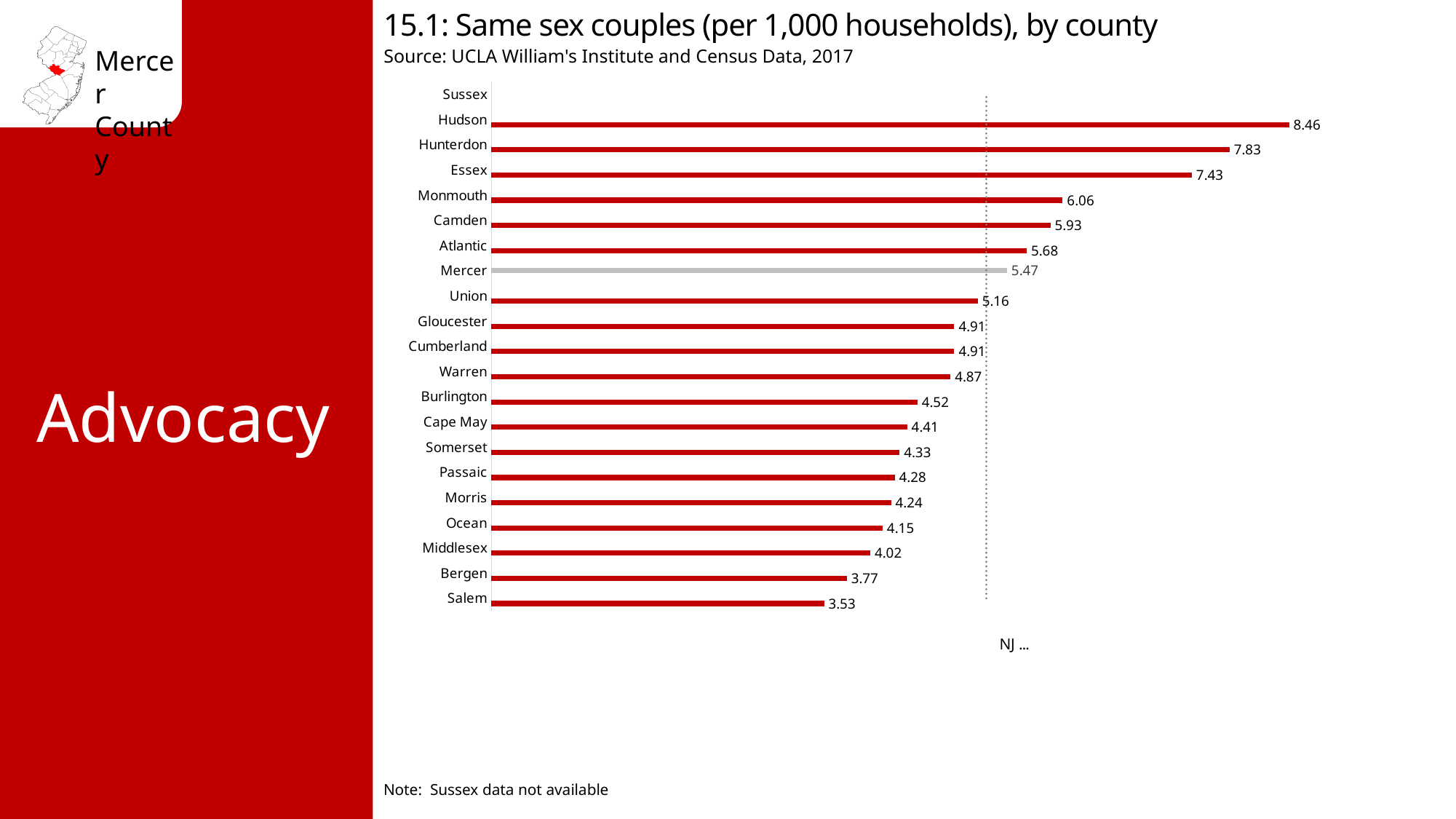
Which has a larger value, Essex or Monmouth? Essex Which county has the lowest value shown? Salem Which has a larger value, Bergen or Middlesex? Middlesex What is the value for Mercer County? 5.47 What is the title of the chart? 15.1: Same sex couples (per 1,000 households), by county What is the difference between the values for Hudson and Mercer? 2.99 What is the value for Salem County? 3.53 How many counties have a data label printed on the chart? 20 What kind of chart is shown? Bar chart What is the value for Hudson County? 8.46 Which county's bar is shown in grey rather than red? Mercer Which county has the highest value shown? Hudson